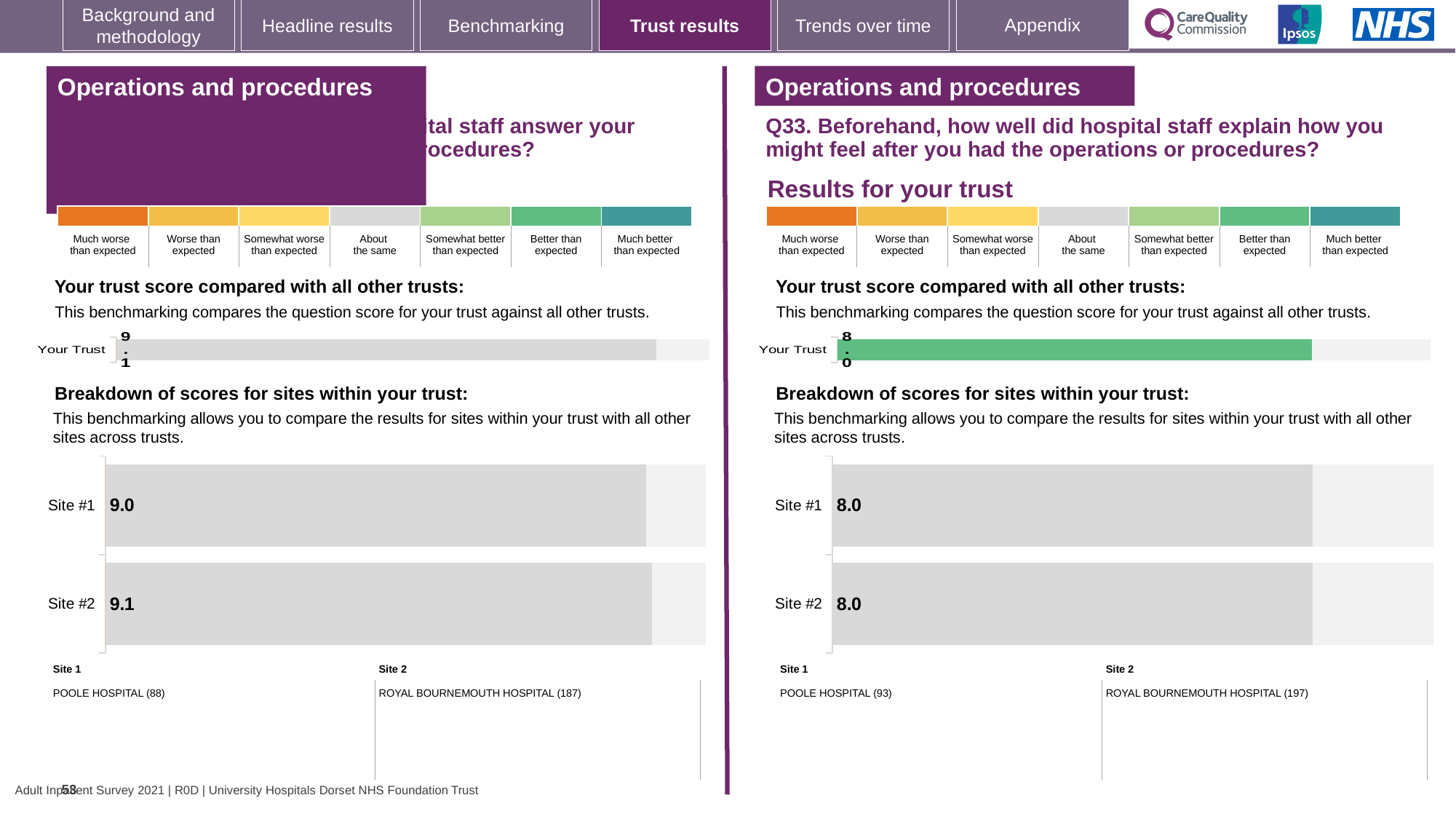
How many sites are shown in the right-hand (Q33) 'Breakdown of scores for sites within your trust' chart? 2 On the left-hand side, what is the score shown for Your Trust in the 'Your trust score compared with all other trusts' chart? 9.1 In the left-hand 'Breakdown of scores for sites within your trust' chart, which site has the higher score? Site #2 In the right-hand (Q33) 'Breakdown of scores for sites within your trust' chart, what is the score for Site #1? 8.0 According to the site key on the right-hand side (Q33), which hospital is Site 2? ROYAL BOURNEMOUTH HOSPITAL (197) In the right-hand (Q33) 'Your trust score compared with all other trusts' chart, what colour is the Your Trust bar? Green In the right-hand (Q33) 'Breakdown of scores for sites within your trust' chart, what is the score for Site #2? 8.0 On the right-hand side (Q33), what is the score shown for Your Trust in the 'Your trust score compared with all other trusts' chart? 8.0 In the left-hand 'Breakdown of scores for sites within your trust' chart, what is the score for Site #1? 9.0 In the left-hand 'Breakdown of scores for sites within your trust' chart, what is the score for Site #2? 9.1 In the left-hand 'Breakdown of scores for sites within your trust' chart, what is the difference between the Site #2 and Site #1 scores? 0.1 What kind of chart is used for the 'Breakdown of scores for sites within your trust' on the left-hand side? Bar chart